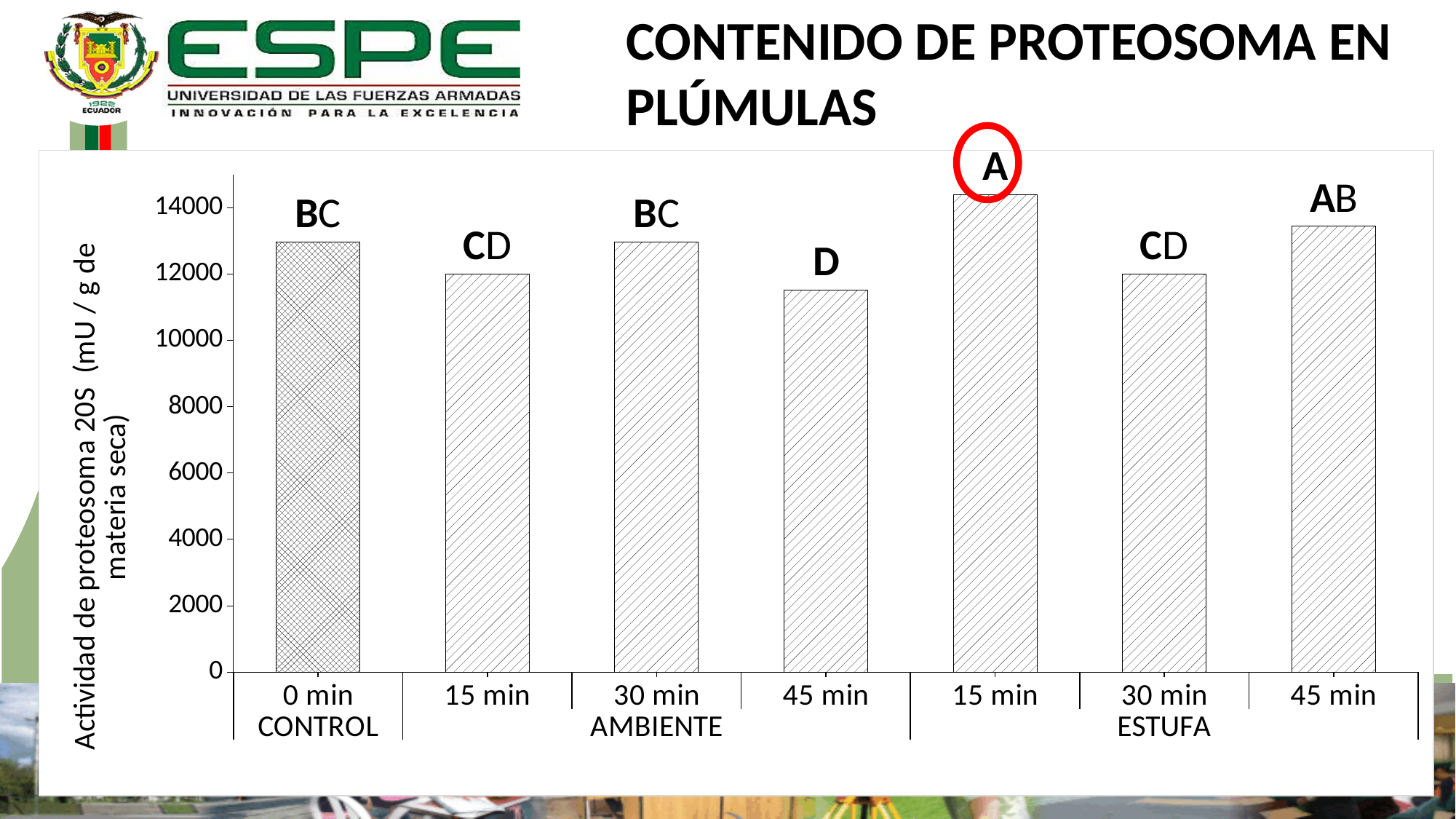
Is the value for 0 min CONTROL greater or less than 12000? greater What kind of chart is shown on the slide? bar chart Which bar has the highest proteasome activity? 15 min ESTUFA How many bars are plotted in the chart? 7 Is the value for 45 min AMBIENTE greater or less than 12000? less What is the title of the chart on the slide? CONTENIDO DE PROTEOSOMA EN PLÚMULAS Which is larger, the value for 45 min AMBIENTE or the value for 45 min ESTUFA? 45 min ESTUFA Which bar has the lowest proteasome activity? 45 min AMBIENTE Is the value for 15 min ESTUFA greater or less than 14000? greater Which is larger, the value for 15 min AMBIENTE or the value for 15 min ESTUFA? 15 min ESTUFA What letter label is printed above the 15 min ESTUFA bar, inside the red circle? A